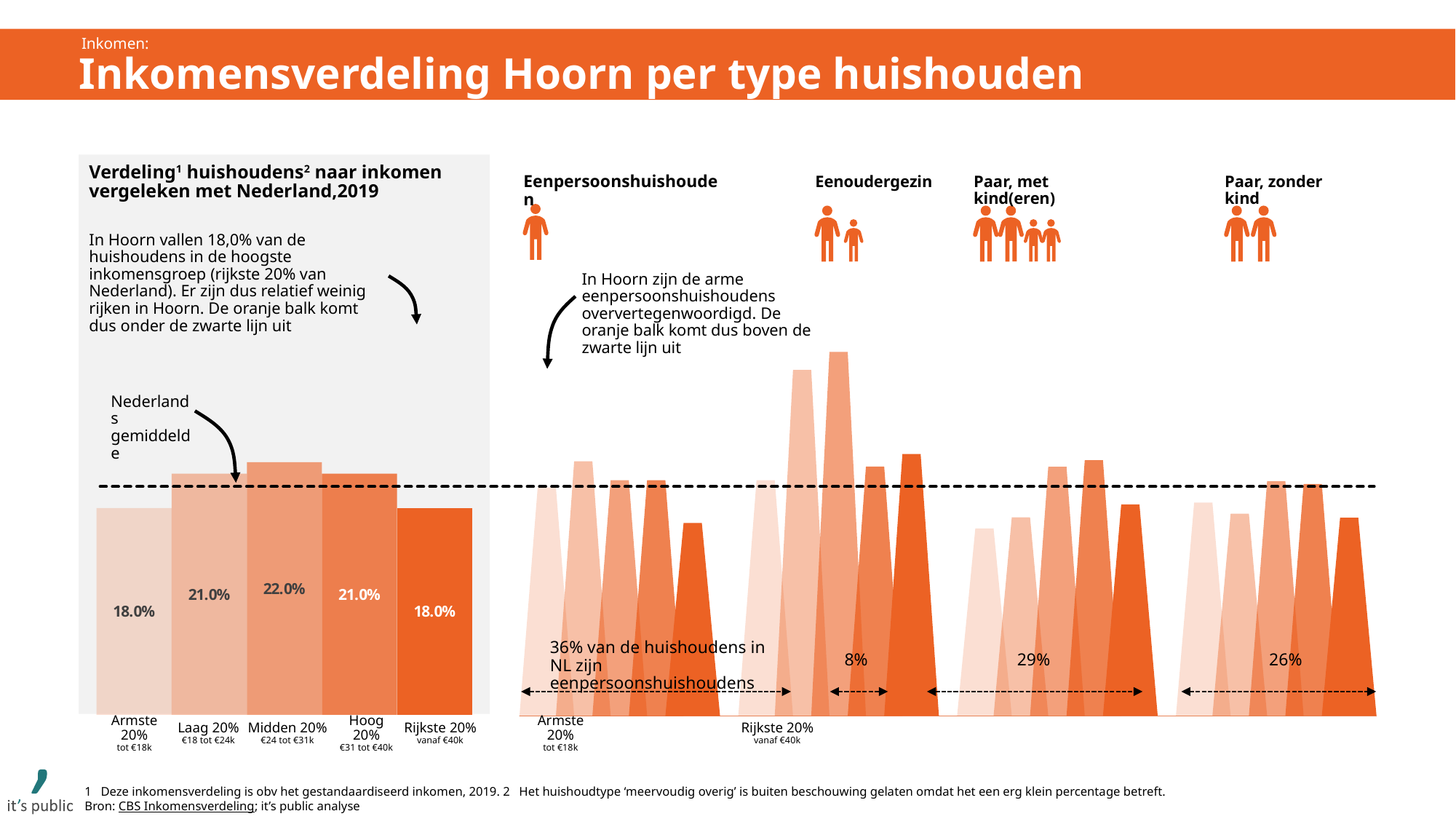
In the left chart, what is the value for Rijkste 20%? 18.0% How many household types are shown in the right chart? 4 In the left chart 'Verdeling huishoudens naar inkomen vergeleken met Nederland, 2019', what is the value for Midden 20%? 22.0% In the left chart, what is the value for Laag 20%? 21.0% In the left chart, what does the dashed black line represent? Nederlands gemiddelde In the left chart, do the values rise or fall from Midden 20% to Rijkste 20%? Fall In the left chart, which is larger: the value for Hoog 20% or the value for Rijkste 20%? Hoog 20% In the left chart, what is the difference between the values for Midden 20% and Armste 20%? 4.0% According to the right chart, what percentage of households in NL are 'Paar, met kind(eren)'? 29% In the left chart, which income group has the highest value? Midden 20% How many income groups are shown in the left chart? 5 What kind of chart is the left chart? Bar chart